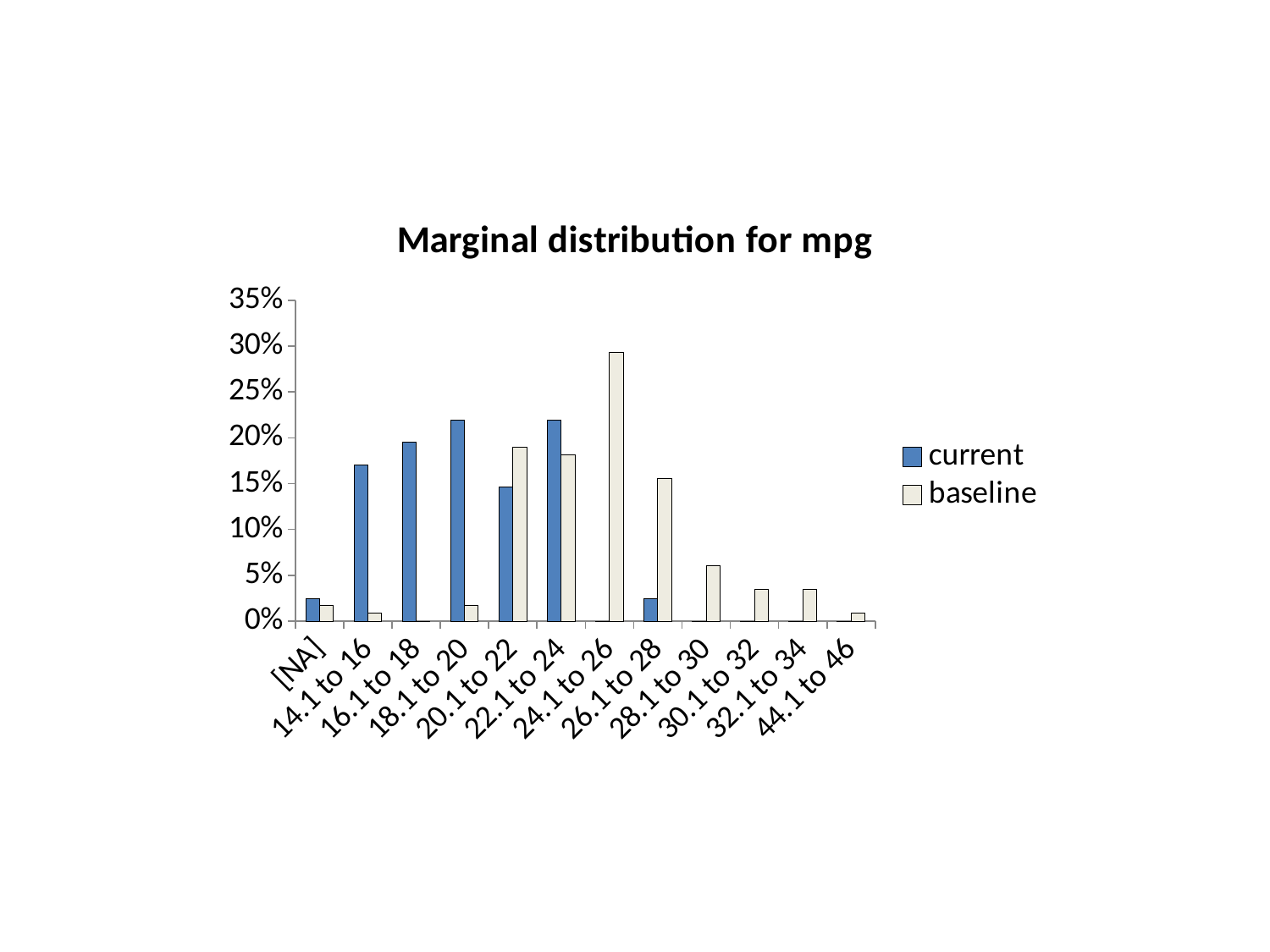
For the category 20.1 to 22, which series has the larger value, current or baseline? baseline Is the baseline value for 28.1 to 30 greater or less than 5%? greater What kind of chart is shown on the slide? bar chart For the category 22.1 to 24, which series has the larger value, current or baseline? current Which series is drawn in blue? current What is the title of the chart? Marginal distribution for mpg Is the baseline value for 24.1 to 26 greater or less than 25%? greater Is the current value for 14.1 to 16 greater or less than 15%? greater How many categories are shown on the x axis? 12 Which category has the highest baseline value? 24.1 to 26 How many series does the legend list? 2